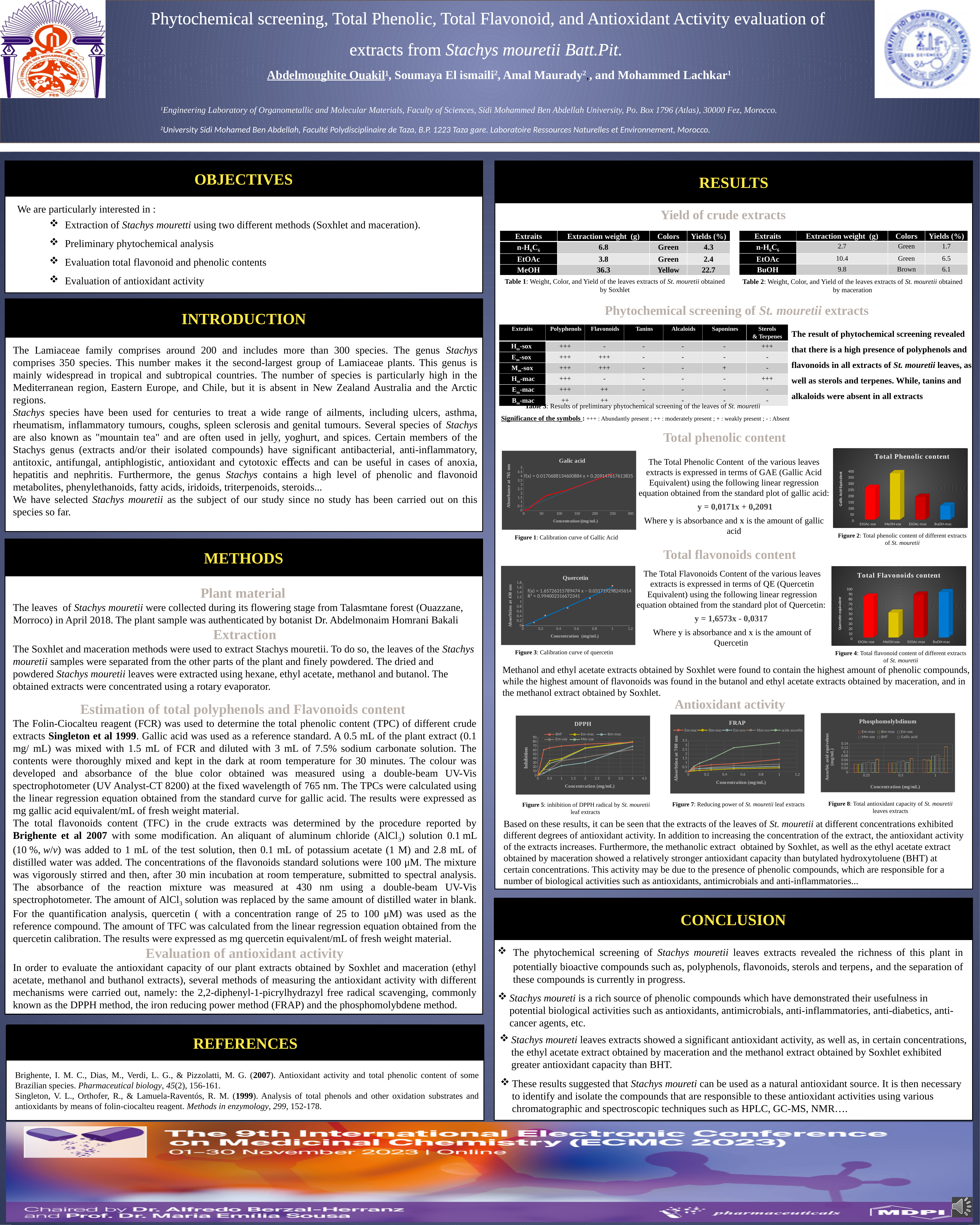
How many extracts are plotted in the 'Total Phenolic content' chart? 4 In the 'Total Phenolic content' chart, which extract has the highest gallic acid equivalent? MeOH-sox In the 'Total Flavonoids content' chart, which extract has the lowest quercetin equivalent? MeOH-sox In the 'Galic acid' calibration curve (Figure 1), does absorbance rise or fall as concentration increases? rise In the 'Total Phenolic content' chart, is the value for MeOH-sox greater or less than 300? greater How many series does the legend of the 'DPPH' chart list? 5 In the 'Total Flavonoids content' chart, is the value for EtOAc-sox greater or less than 70? greater How many series does the legend of the 'Phosphomolybdinum' chart list? 6 In the 'Total Phenolic content' chart, is the value for BuOH-mac greater or less than 150? less What kind of chart is the 'Phosphomolybdinum' chart (Figure 8)? bar chart In the 'Total Phenolic content' chart, which extract has the lowest gallic acid equivalent? BuOH-mac